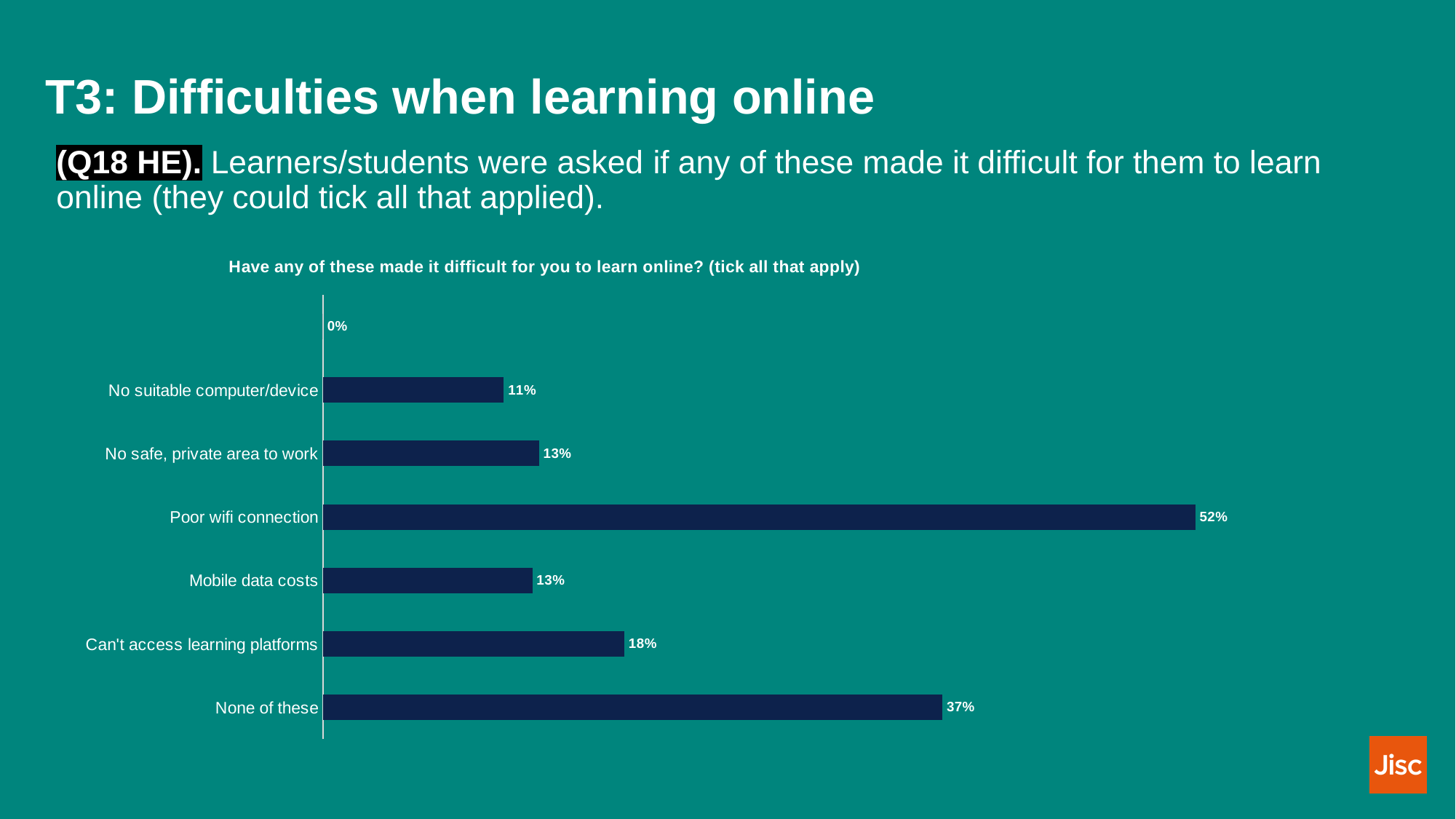
What is the title of the chart? Have any of these made it difficult for you to learn online? (tick all that apply) What is the value for 'None of these'? 37% What percentage is shown for 'Can't access learning platforms'? 18% What percentage of learners/students selected 'Poor wifi connection' as a difficulty? 52% Which labelled difficulty has the highest percentage? Poor wifi connection What is the difference in percentage points between 'Poor wifi connection' and 'None of these'? 15 Which labelled difficulty has the lowest percentage? No suitable computer/device What is the difference in percentage points between 'Can't access learning platforms' and 'No suitable computer/device'? 7 Which is larger: the value for 'Can't access learning platforms' or the value for 'No safe, private area to work'? Can't access learning platforms What percentage is shown for 'Mobile data costs'? 13% What kind of chart is shown on the slide? Bar chart What is the value shown for 'No suitable computer/device'? 11%